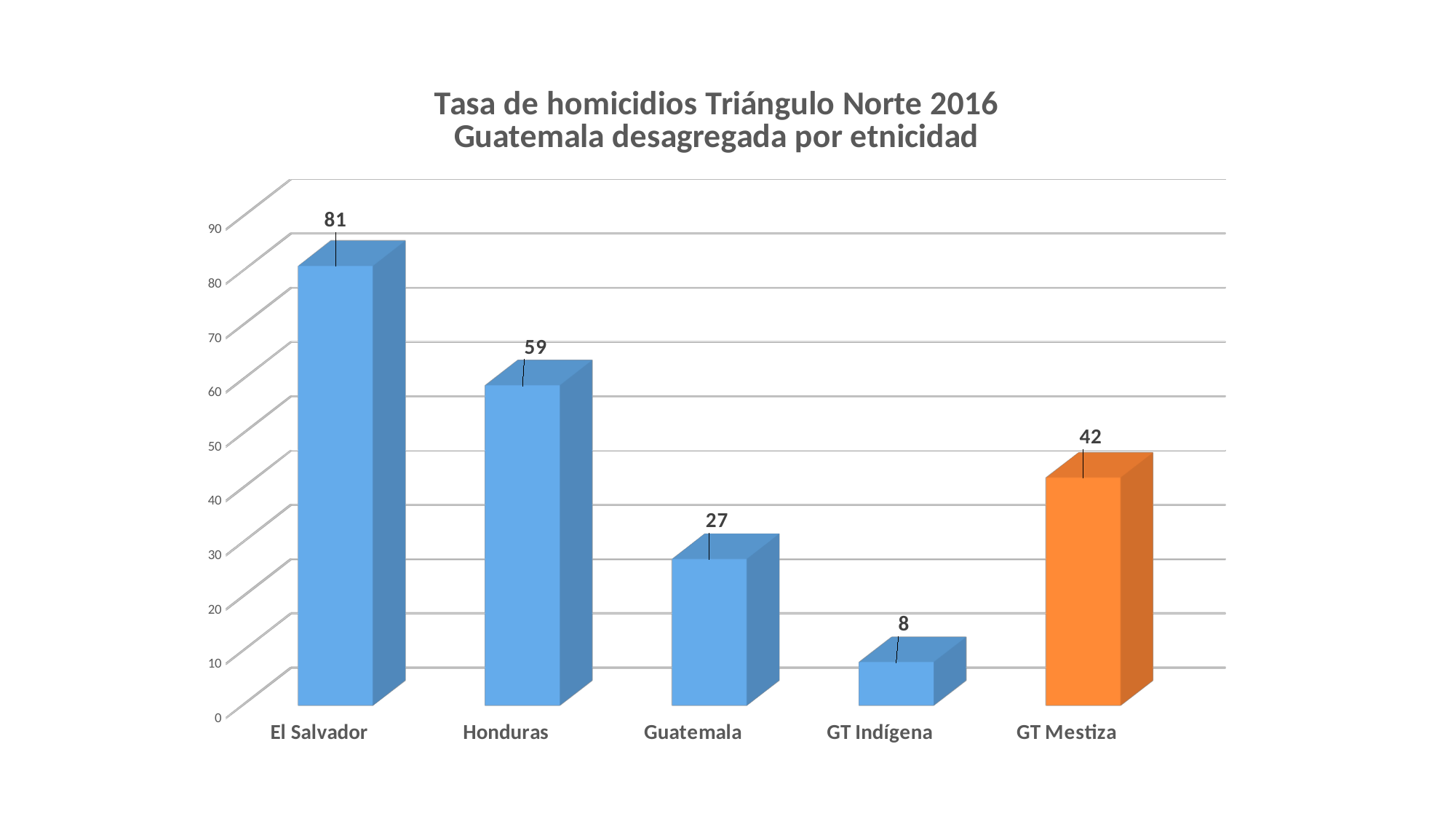
What kind of chart is shown on the slide? Bar chart Which category has the lowest value? GT Indígena What is the difference between the values for GT Mestiza and GT Indígena? 34 What is the value shown for GT Indígena? 8 What is the difference between the values for El Salvador and Honduras? 22 What is the value shown for Honduras? 59 Which category has the highest value? El Salvador What is the value shown for GT Mestiza? 42 How many categories are shown on the x axis? 5 What is the homicide rate shown for El Salvador? 81 Which is larger, the value for Guatemala or the value for GT Mestiza? GT Mestiza Which bar is coloured orange rather than blue? GT Mestiza